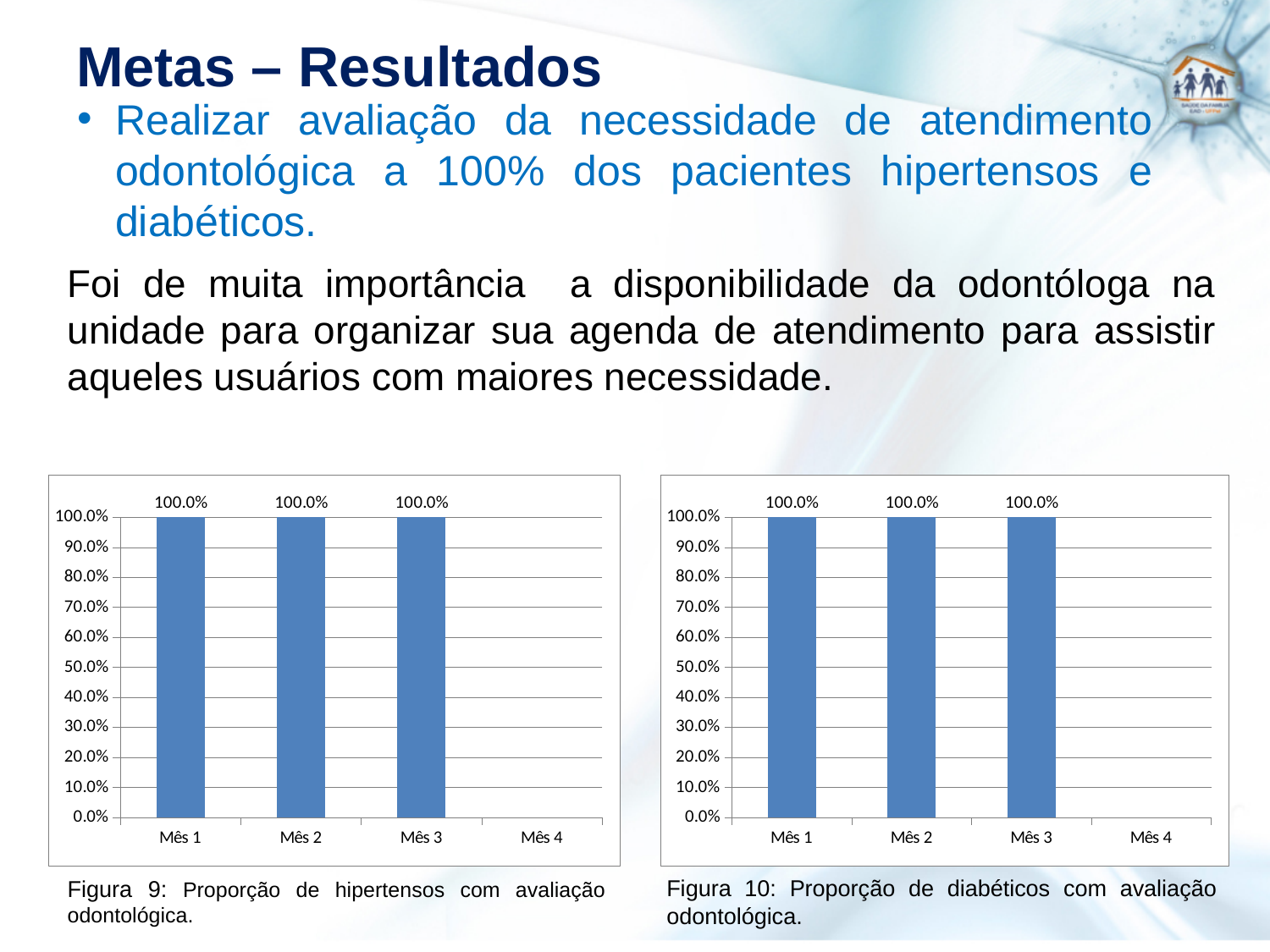
In the left chart (Figura 9), what is the difference between the values for Mês 1 and Mês 3? 0.0% In the left chart (Figura 9), what is the value for Mês 1? 100.0% What kind of chart is the right chart (Figura 10)? Bar chart In the left chart (Figura 9), what is the value for Mês 3? 100.0% How many categories are shown on the x axis of the left chart (Figura 9)? 4 How many categories are shown on the x axis of the right chart (Figura 10)? 4 Which category in the right chart (Figura 10) has no bar plotted? Mês 4 In the left chart (Figura 9), is the value for Mês 2 greater or less than 50.0%? greater What kind of chart is the left chart (Figura 9)? Bar chart In the right chart (Figura 10), what is the value for Mês 3? 100.0% In the right chart (Figura 10), what is the value for Mês 2? 100.0% In the right chart (Figura 10), do the values rise, fall or stay flat from Mês 1 to Mês 3? Stay flat